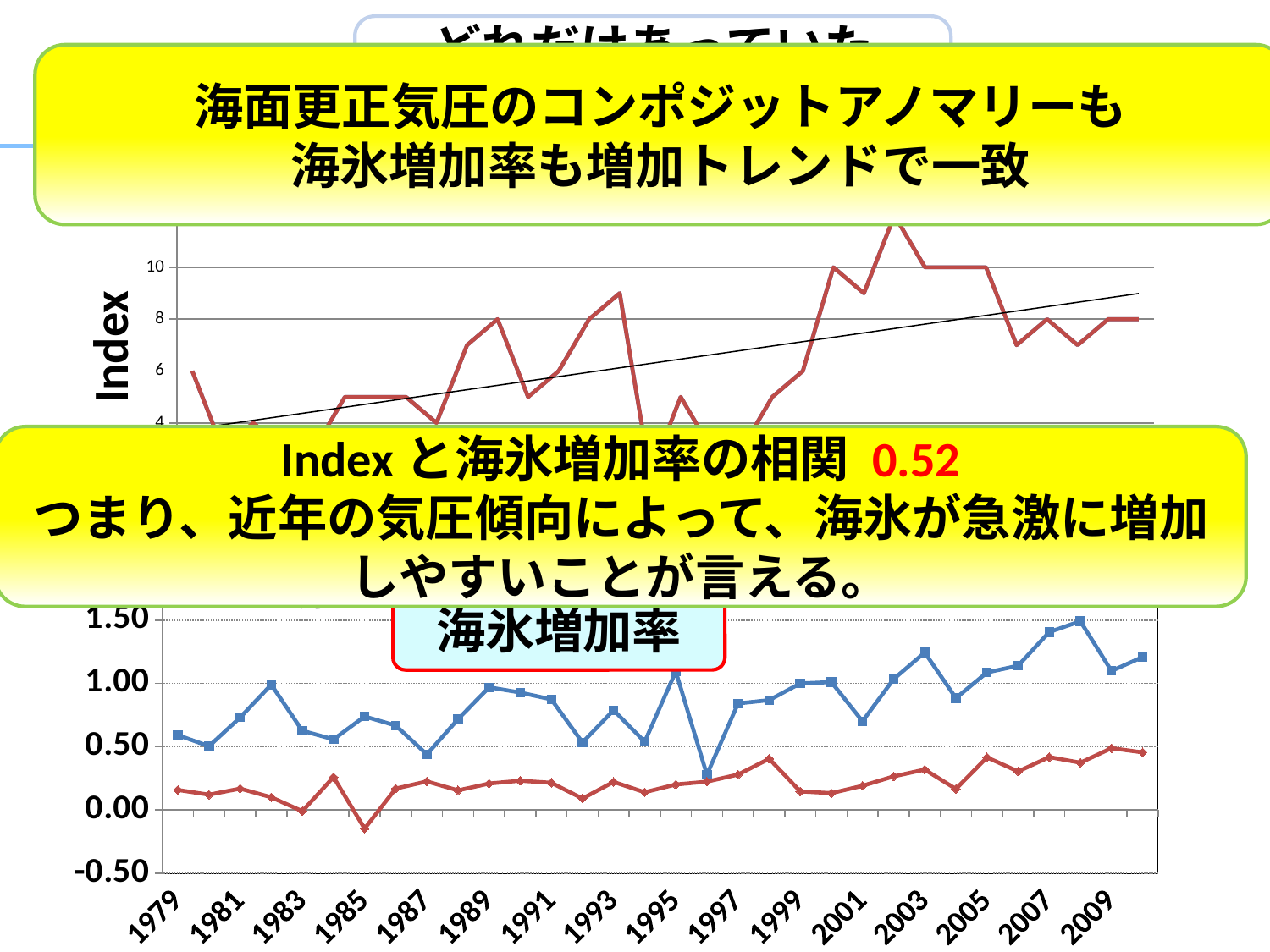
In the bottom chart (海氷増加率), in which year does the blue line reach its lowest value? 1996 How many year labels are shown on the x axis of the bottom chart (海氷増加率)? 16 What kind of chart is the bottom chart titled 海氷増加率? line chart In the bottom chart (海氷増加率), is the blue line's value for 2008 greater or less than 1.00? greater In the top chart (Index), is the peak value around 2002 greater or less than 10? greater In the bottom chart (海氷増加率), is the blue line's value for 1996 greater or less than 0.50? less In the top chart (Index), does the straight trend line rise or fall from left to right? rise What kind of chart is the top chart with the y-axis labelled Index? line chart In the bottom chart (海氷増加率), for 2008, which line has the larger value, the blue line or the red line? blue line In the bottom chart (海氷増加率), in which year does the blue line reach its highest value? 2008 In the bottom chart (海氷増加率), does the blue line generally rise or fall from 1979 to 2009? rise